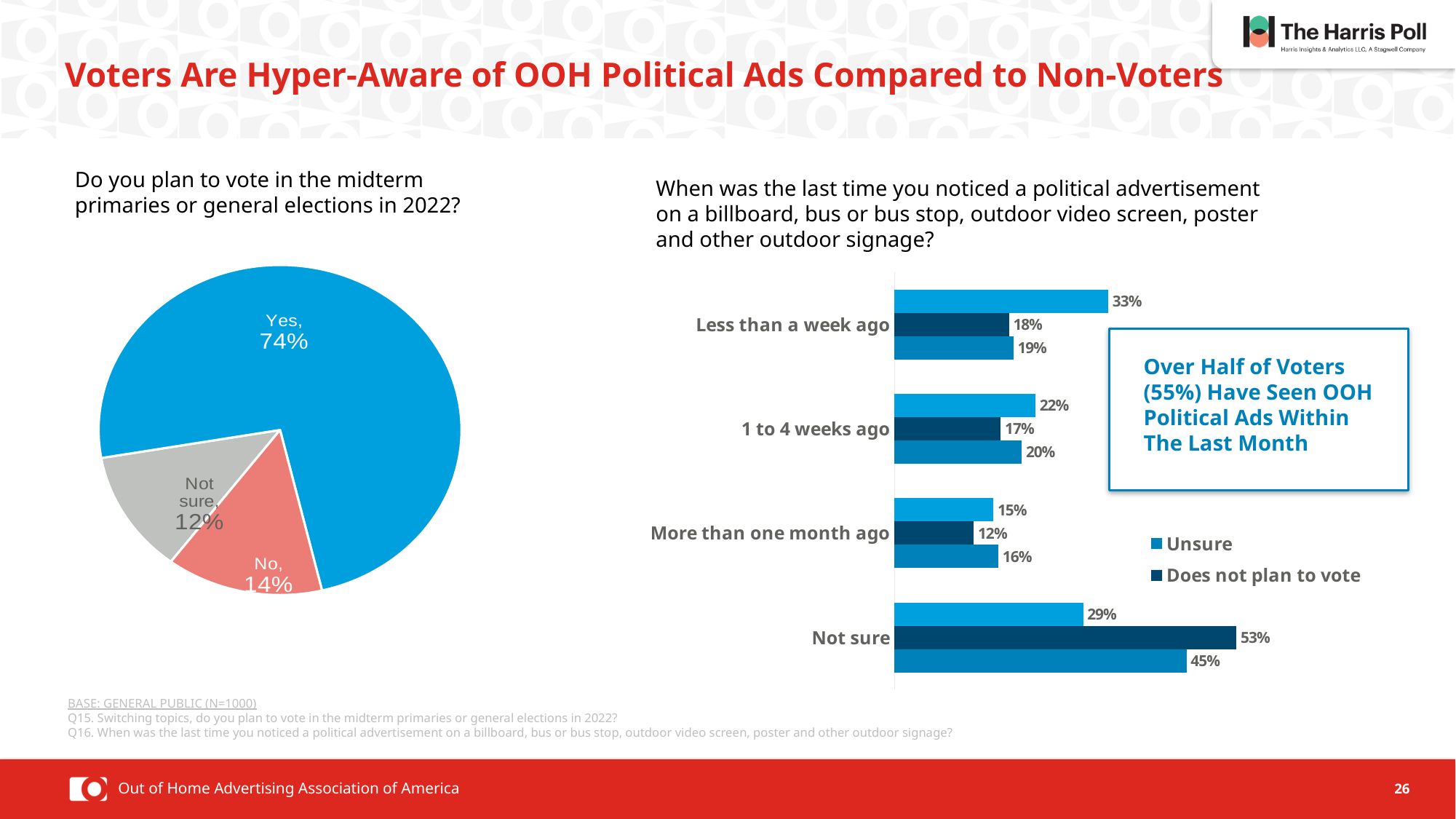
In the pie chart on the left, which response has the smallest slice? Not sure In the pie chart on the left, which response has the largest slice? Yes In the pie chart on the left, what percentage answered Not sure? 12% According to the callout box on the right, what percentage of voters have seen OOH political ads within the last month? 55% In the bar chart on the right, how many series does the legend list? 2 What type of chart is used on the right side of the slide for the question about noticing political advertisements? Bar chart In the pie chart on the left, how many slices are there? 3 In the bar chart on the right, how many time-period categories are shown on the axis? 4 In the pie chart on the left, what share of respondents answered Yes to planning to vote in the 2022 midterm elections? 74% In the pie chart on the left, how many percentage points larger is the Yes slice than the No slice? 60 percentage points In the pie chart on the left, what percentage answered No? 14% In the bar chart on the right, what is the highest value shown on any bar, and in which category does it appear? 53%, Not sure